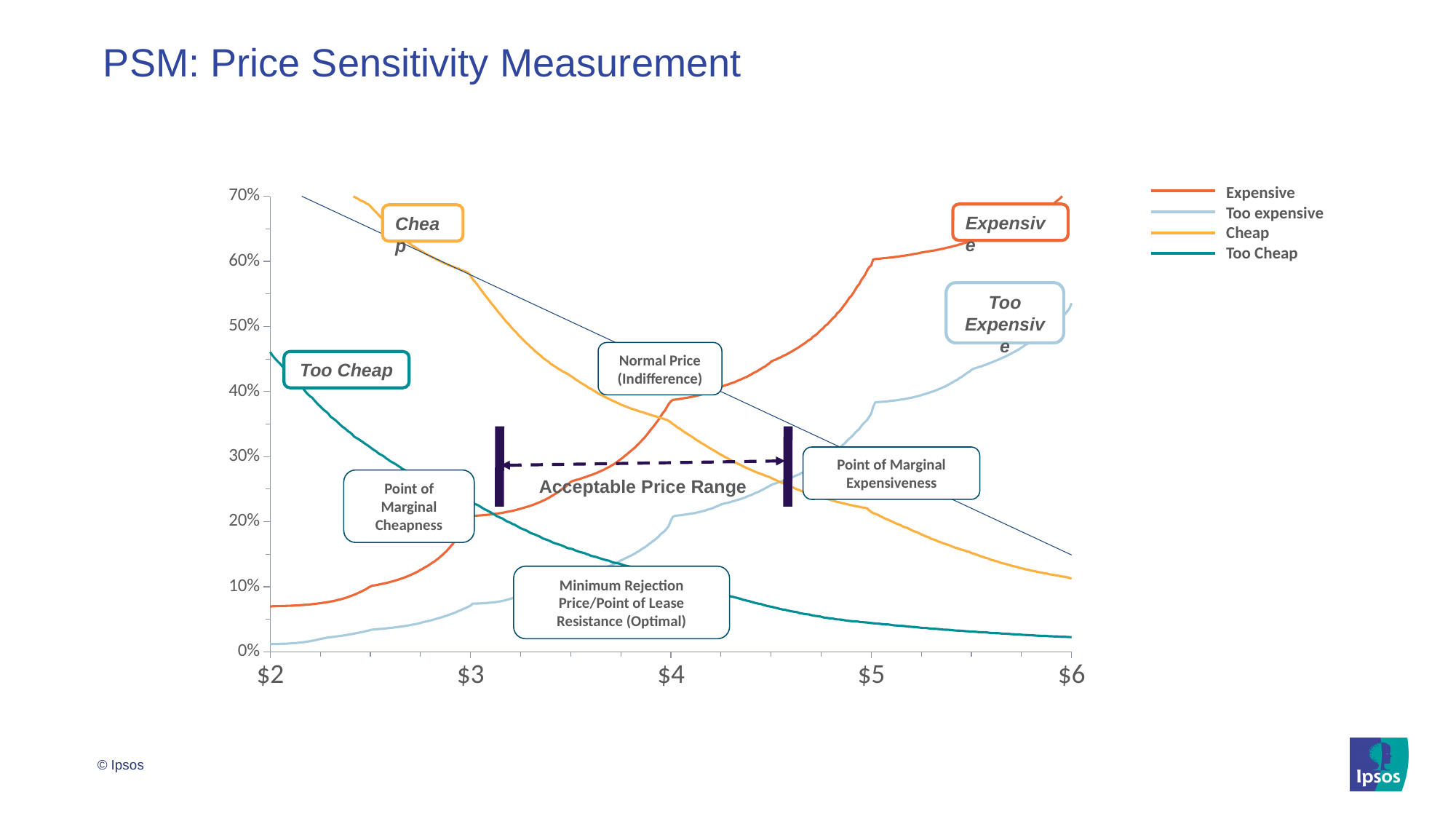
Does the Expensive line rise or fall as price increases from $2 to $6? rise Is the value of the Too expensive line at $6 greater or less than 50%? greater What label is written on the dashed arrow between the two vertical bars? Acceptable Price Range What kind of chart is shown on the slide? line chart Does the Cheap line rise or fall as price increases along the x axis? fall How many series does the legend list? 4 Is the value of the Expensive line at $2 greater or less than 10%? less At $2, which line is higher: Too Cheap or Expensive? Too Cheap Does the Too Cheap line rise or fall as price increases along the x axis? fall Is the value of the Too Cheap line at $6 greater or less than 10%? less At $6, which line is higher: Expensive or Too expensive? Expensive